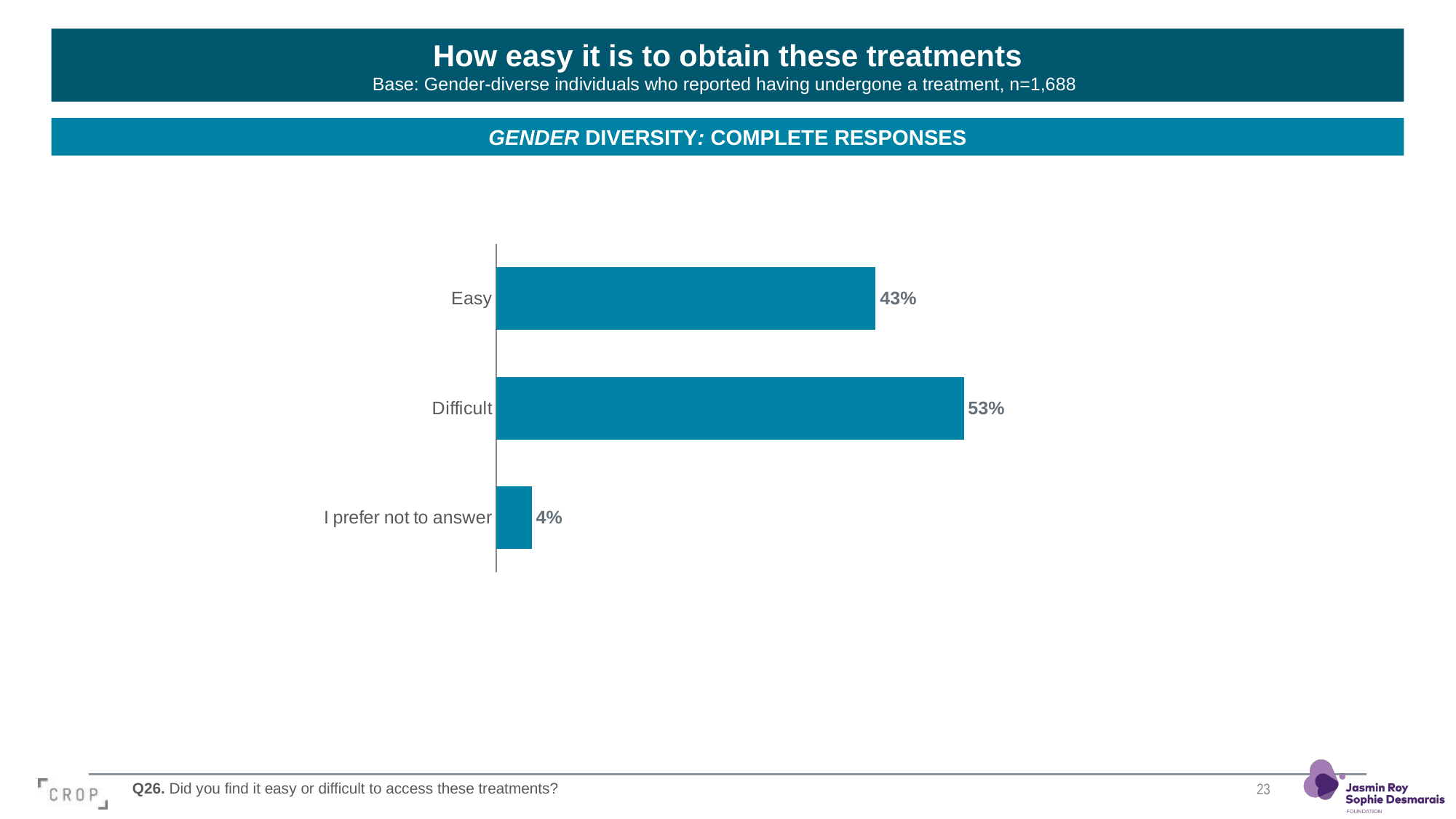
What percentage of respondents chose 'I prefer not to answer'? 4% Which response category has the lowest percentage? I prefer not to answer What type of chart is used on this slide? Bar chart Which is larger, the percentage for 'Easy' or for 'Difficult'? Difficult What is the base size (n) stated for the chart? n=1,688 How many response categories are shown in the chart? 3 Which response category has the highest percentage? Difficult What percentage of respondents said it was difficult to obtain these treatments? 53% What percentage of respondents said it was easy to obtain these treatments? 43% What is the difference in percentage points between 'Easy' and 'I prefer not to answer'? 39 What is the title of the chart on this slide? How easy it is to obtain these treatments What is the difference in percentage points between 'Difficult' and 'Easy'? 10